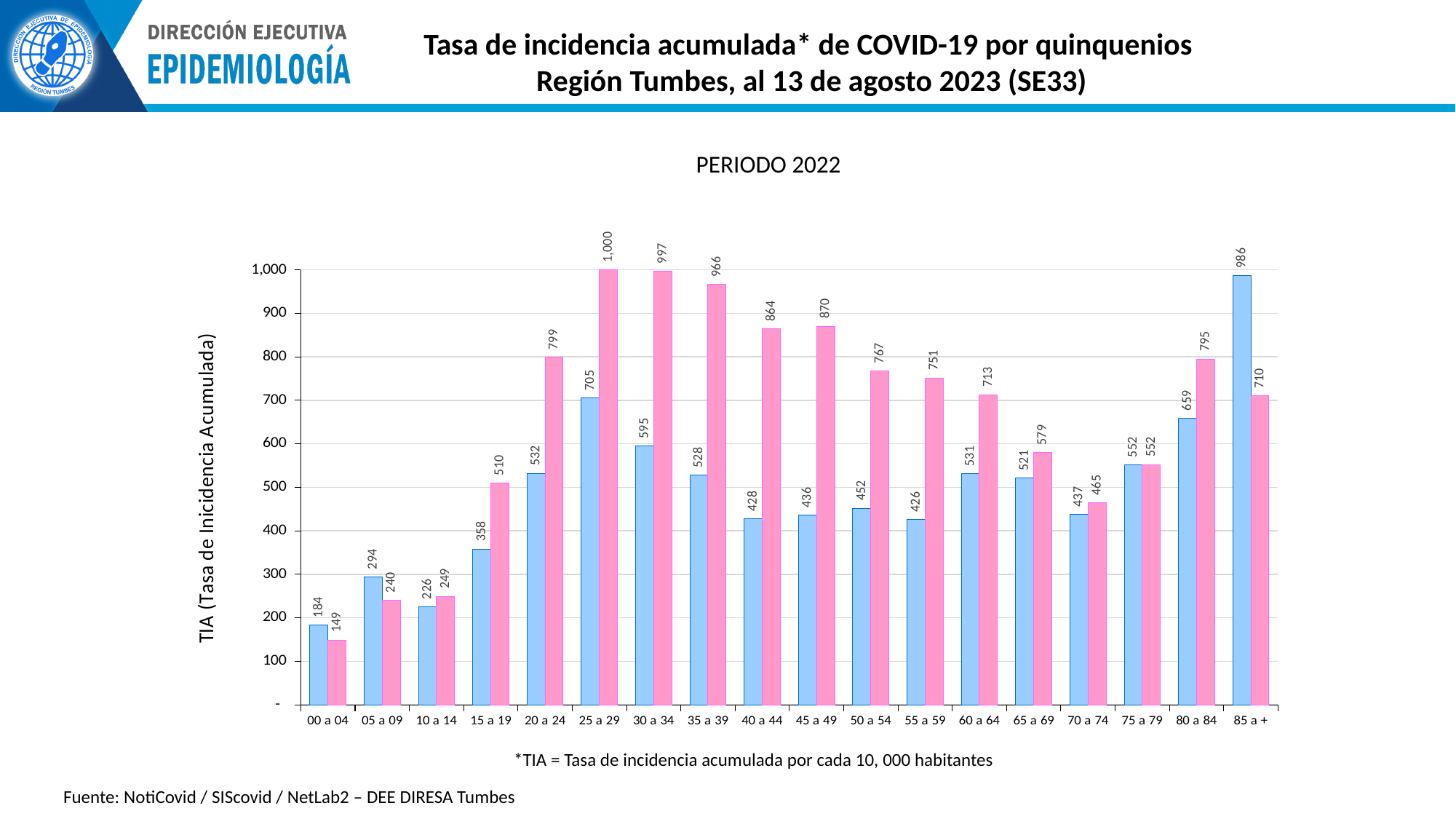
What is the value of the pink bar for the 45 a 49 age group? 870 What is the value of the blue bar for the 25 a 29 age group? 705 What type of chart is shown on the slide? bar chart What is the label of the y axis? TIA (Tasa de Incidencia Acumulada) What is the difference between the pink bar and the blue bar for the 20 a 24 age group? 267 What is the value of the blue bar for the 85 a + age group? 986 Which age group has the lowest blue bar? 00 a 04 Which age group has the highest pink bar? 25 a 29 Is the value of the blue bar for the 30 a 34 age group greater or less than 500? greater How many age groups are shown on the x axis? 18 Which age group has the lowest pink bar? 00 a 04 Which is larger for the 80 a 84 age group, the blue bar or the pink bar? the pink bar